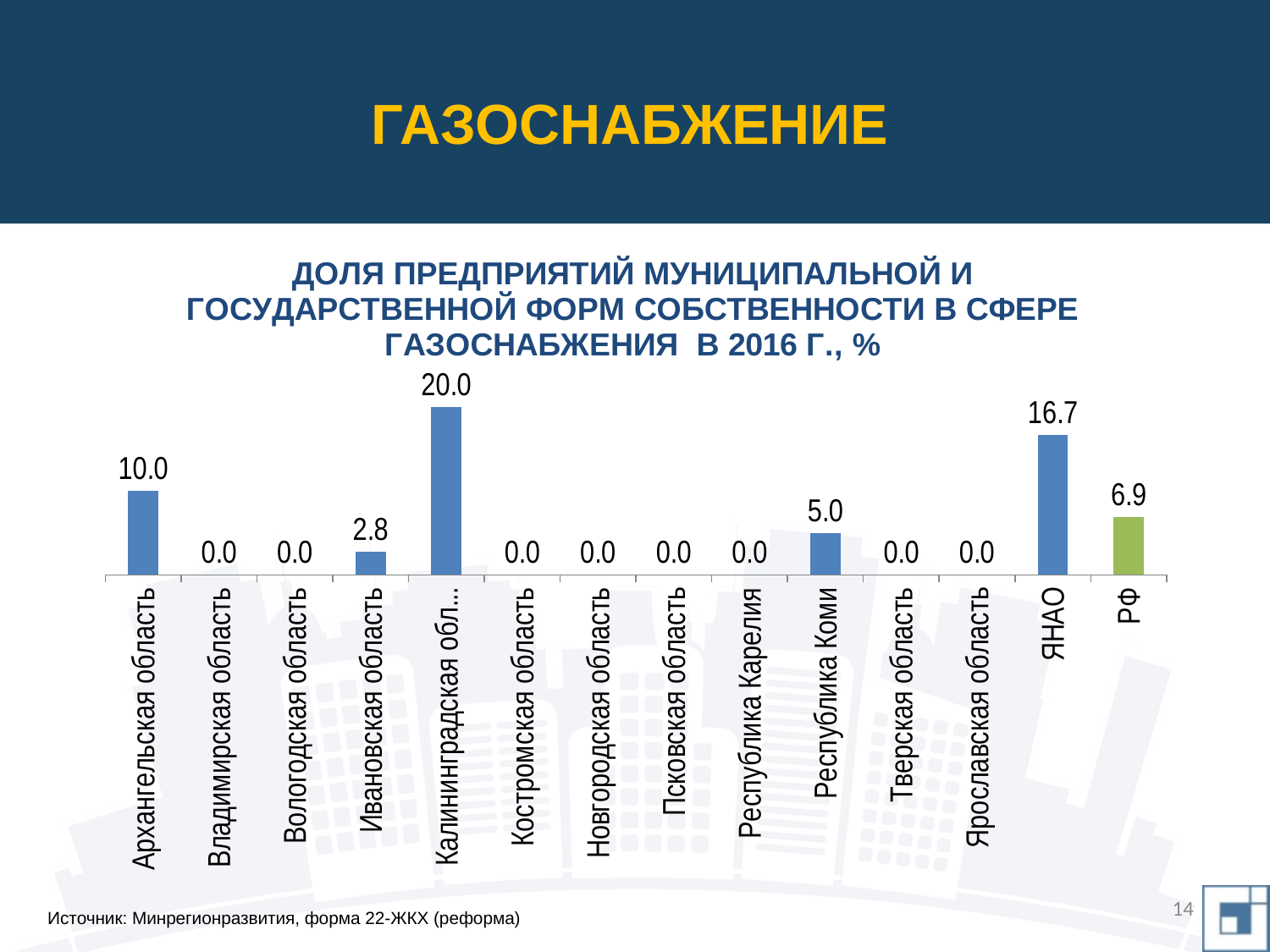
What is the value for РФ? 6.9 What is the difference between the values for Архангельская область and Республика Коми? 5.0 What is the value for Архангельская область? 10.0 Which is larger, the value for Архангельская область or the value for ЯНАО? ЯНАО What kind of chart is shown on the slide? Bar chart What is the value for Ивановская область? 2.8 Which bar is shown in a different colour (green) from the others? РФ What is the value for ЯНАО? 16.7 What is the difference between the values for ЯНАО and РФ? 9.8 How many categories are shown on the x axis? 14 What is the value for Республика Коми? 5.0 Which category has the highest value? Калининградская обл...